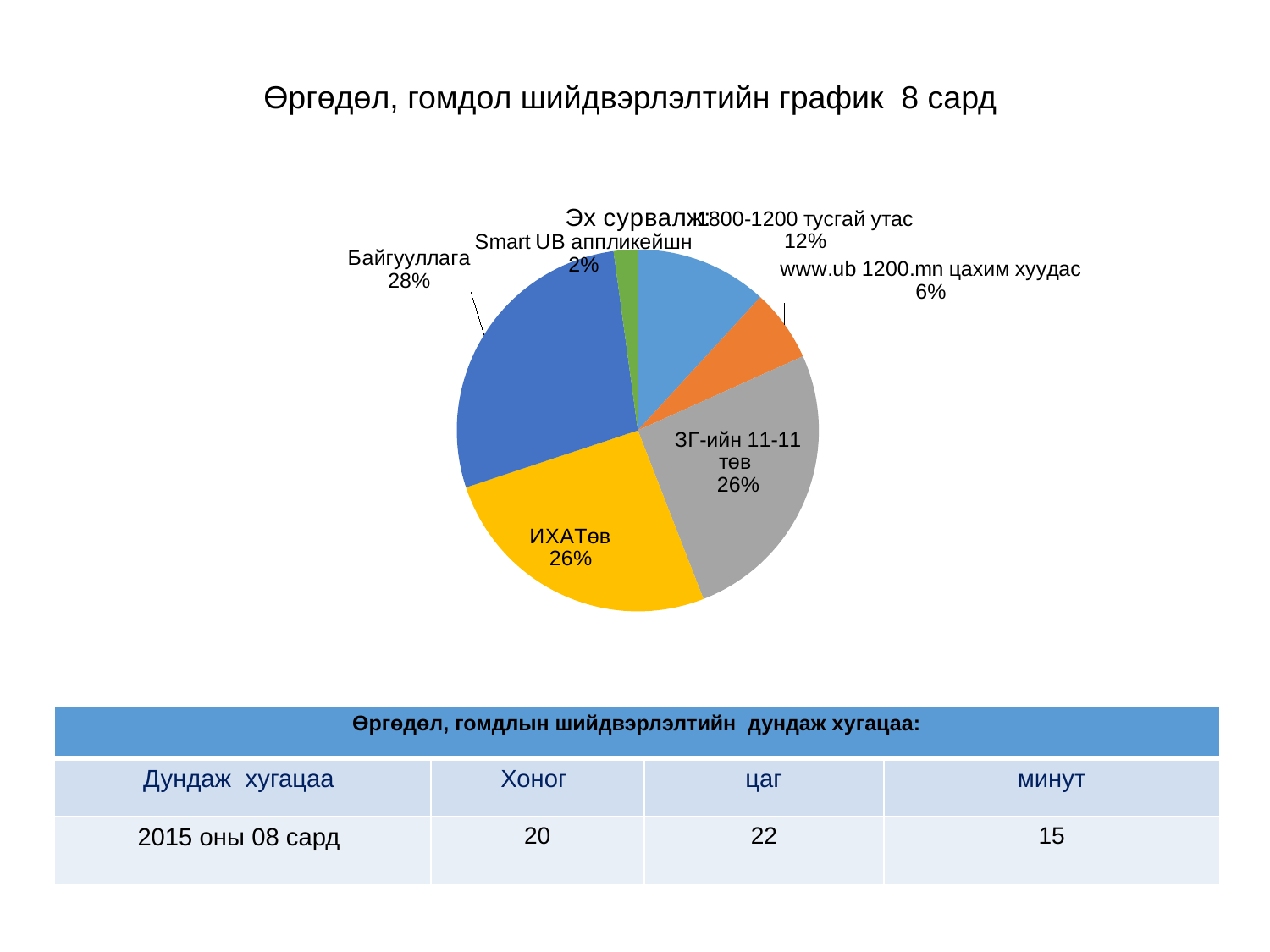
What share of the pie does Байгууллага have? 28% Which slice of the pie is the smallest? Smart UB аппликейшн What share of the pie does ЗГ-ийн 11-11 төв have? 26% What share of the pie does www.ub 1200.mn цахим хуудас have? 6% What kind of chart is shown on the slide? pie chart Which is larger, the share for 1800-1200 тусгай утас or the share for www.ub 1200.mn цахим хуудас? 1800-1200 тусгай утас How many slices does the pie chart have? 6 What colour is the ИХАТөв slice of the pie? yellow What is the difference in percentage points between Байгууллага and www.ub 1200.mn цахим хуудас? 22 Which slice of the pie is the largest? Байгууллага